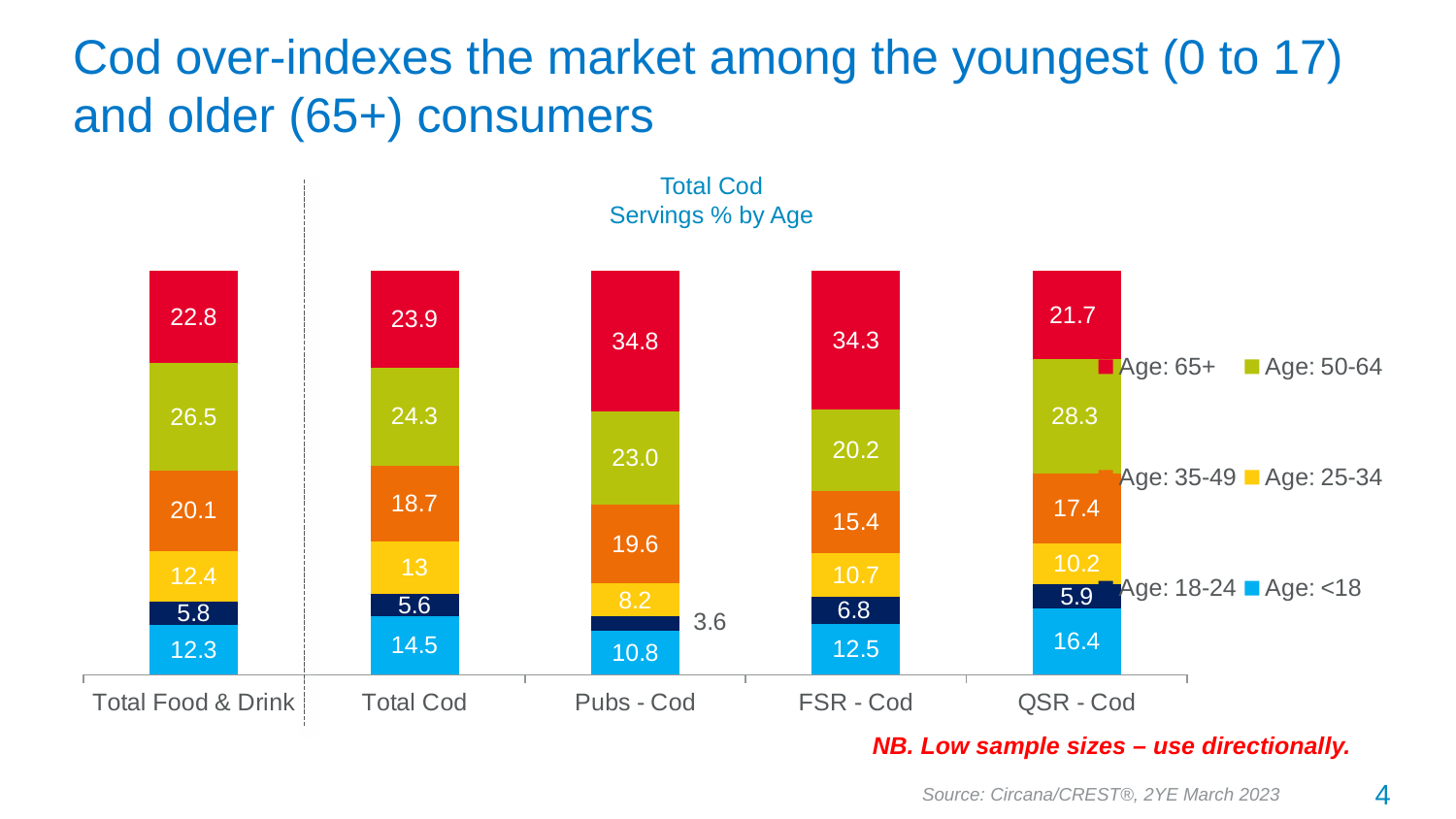
What is the Age: 18-24 value for Pubs - Cod? 3.6 What is the difference between the Age: 50-64 values for QSR - Cod and FSR - Cod? 8.1 Which category has the lowest Age: 18-24 value? Pubs - Cod What kind of chart is shown on the slide? Stacked bar chart Which is larger, the Age: 35-49 value for Total Food & Drink or for Total Cod? Total Food & Drink Which category has the highest Age: 65+ value? Pubs - Cod How many categories are shown along the x axis? 5 How many age groups does the legend list? 6 What is the title of the chart? Total Cod Servings % by Age What is the Age: 65+ value for Pubs - Cod? 34.8 What is the total of the stacked bar for Total Cod? 100.0 What is the Age: <18 value for QSR - Cod? 16.4